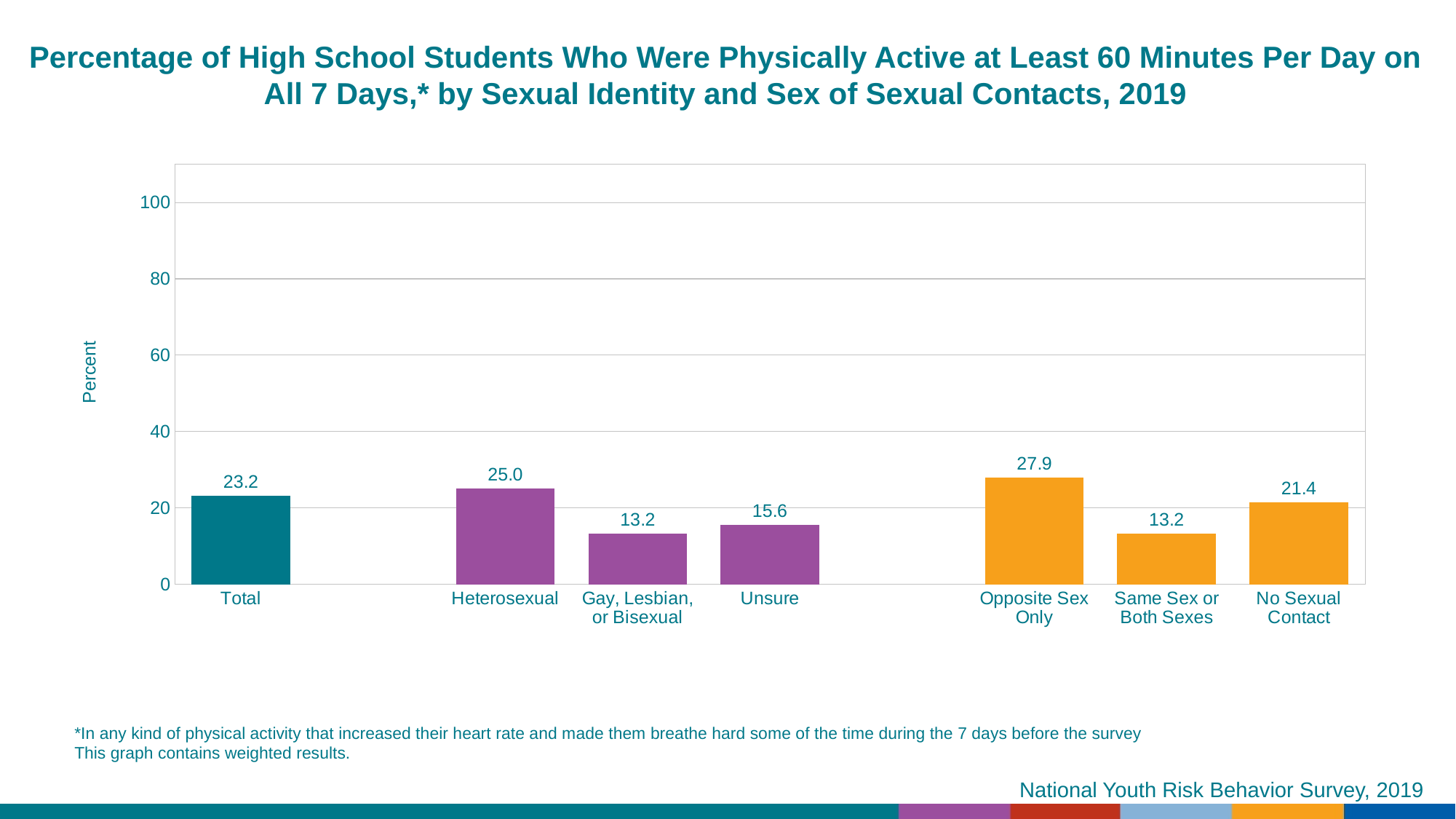
What is the value for Heterosexual students? 25.0 What is the value for students with Opposite Sex Only sexual contacts? 27.9 Which category has the highest value? Opposite Sex Only Is the value for Opposite Sex Only greater or less than 20? greater What is the value for Total? 23.2 Which is larger, the value for Unsure or the value for Gay, Lesbian, or Bisexual? Unsure What is the label of the y axis? Percent How many categories are shown on the x axis? 7 What is the value for students with No Sexual Contact? 21.4 What is the difference between the values for Opposite Sex Only and Same Sex or Both Sexes? 14.7 What is the difference between the values for Heterosexual and Gay, Lesbian, or Bisexual students? 11.8 What kind of chart is shown on the slide? Bar chart